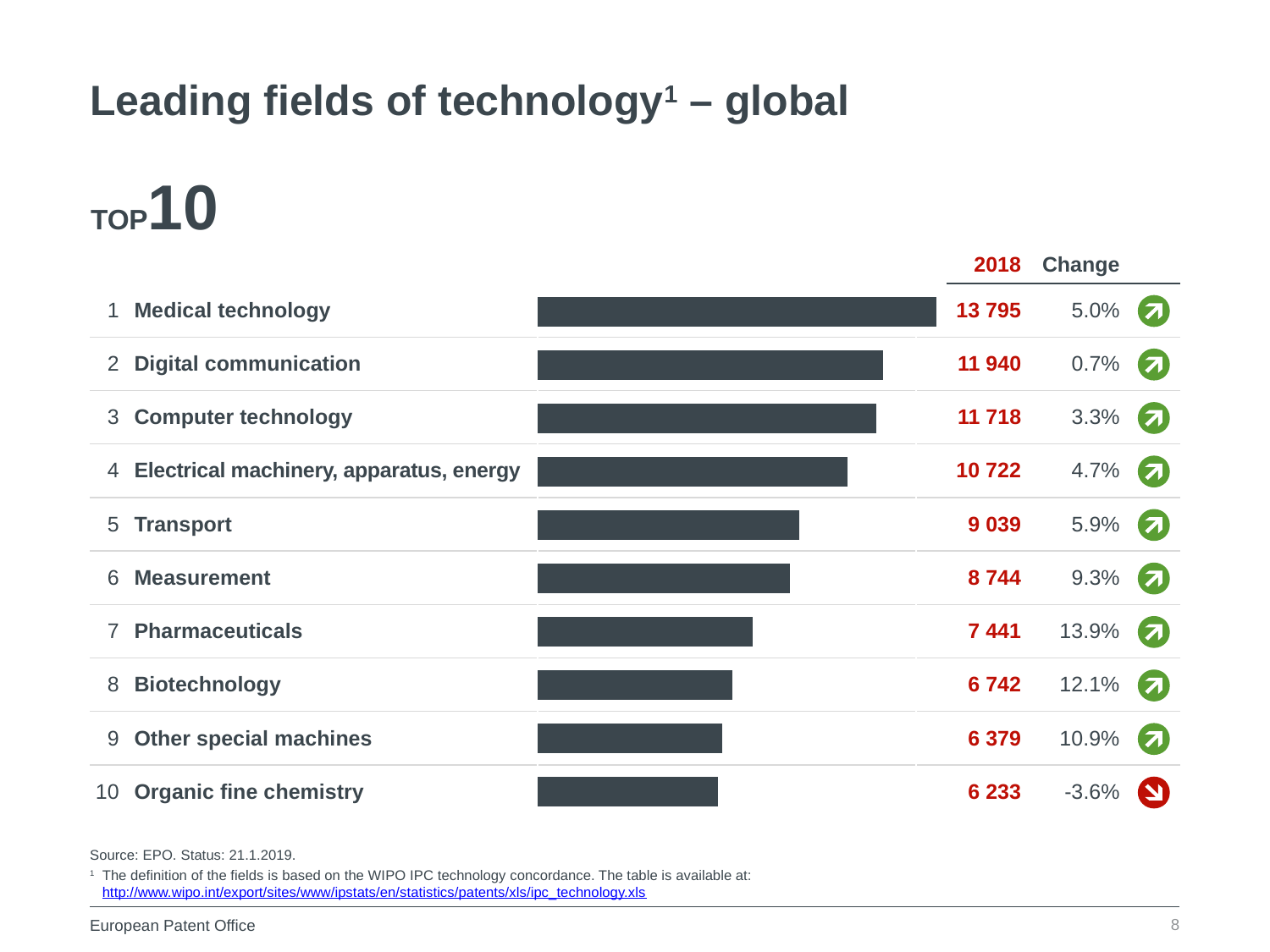
Which has a larger 2018 value, Computer technology or Electrical machinery, apparatus, energy? Computer technology What is the change shown for Pharmaceuticals? 13.9% What is the 2018 value for Transport? 9 039 Which field has the lowest 2018 value? Organic fine chemistry Which field is the only one with a negative change? Organic fine chemistry What is the 2018 value for Medical technology? 13 795 Which field has the highest 2018 value? Medical technology What is the difference between the 2018 values for Biotechnology and Other special machines? 363 Which field has the largest percentage change? Pharmaceuticals What kind of chart is shown on the slide? Bar chart What is the difference between the 2018 values for Medical technology and Digital communication? 1 855 How many fields of technology are listed in the chart? 10